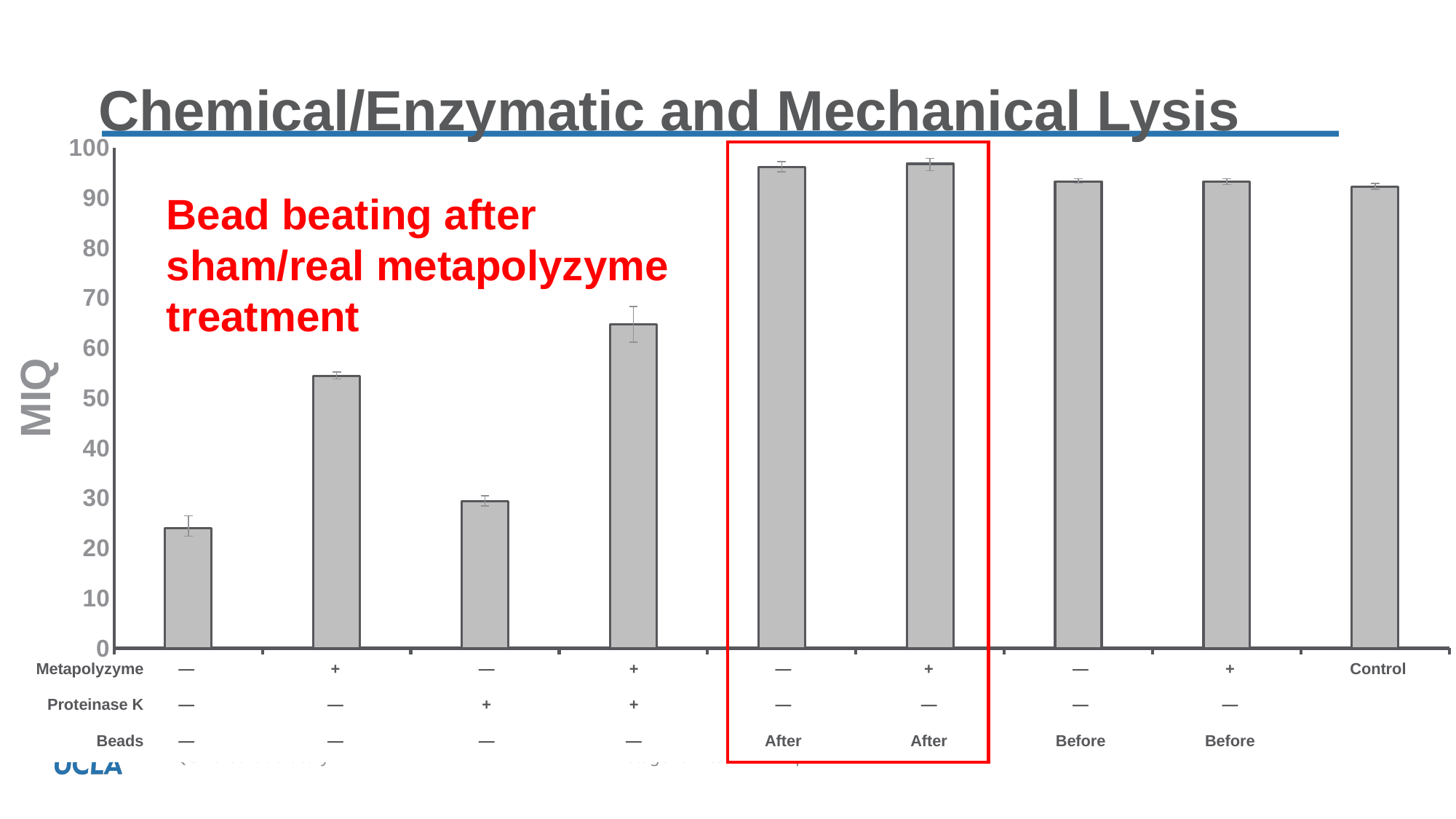
Is the MIQ value for the bar with Metapolyzyme +, Proteinase K —, Beads — greater or less than 50? greater Is the MIQ value for the bar with Metapolyzyme +, Proteinase K +, Beads — greater or less than 60? greater Which has a higher MIQ value: the bar with Metapolyzyme —, Proteinase K +, Beads — or the bar with Metapolyzyme +, Proteinase K —, Beads —? Metapolyzyme +, Proteinase K —, Beads — What kind of chart is shown on the slide? bar chart Is the MIQ value for the bar with Metapolyzyme —, Proteinase K +, Beads — greater or less than 40? less What is the label on the y axis of the chart? MIQ Which bar has the lowest MIQ value? Metapolyzyme —, Proteinase K —, Beads — (the first bar) What is the title of the slide containing the chart? Chemical/Enzymatic and Mechanical Lysis How many bars are plotted in the chart? 9 Which has a higher MIQ value: the bar with Beads After and Metapolyzyme — or the bar with Metapolyzyme +, Proteinase K +, Beads —? Beads After, Metapolyzyme —